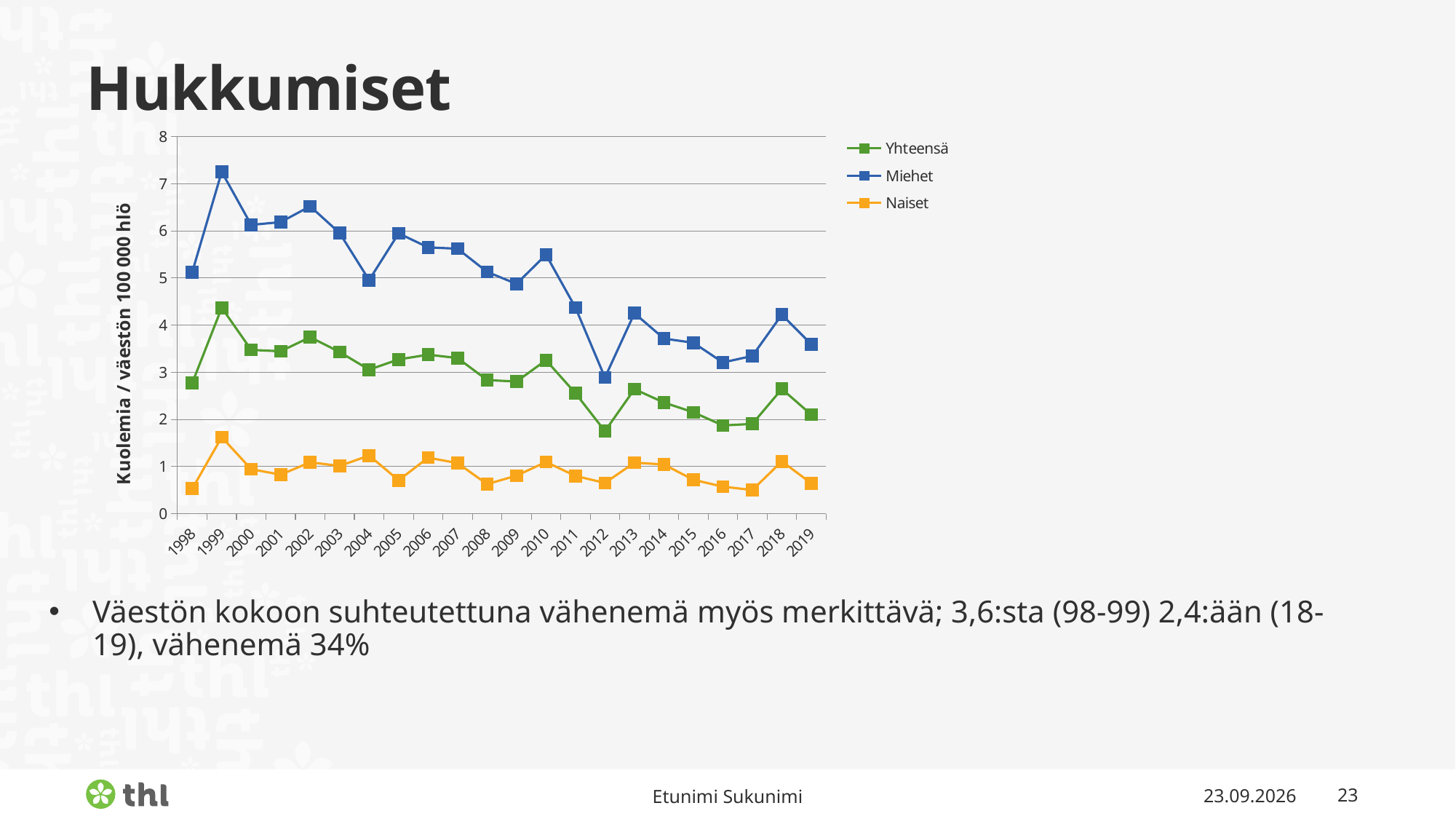
In which year does the Miehet series reach its highest value? 1999 What is the title of the vertical axis? Kuolemia / väestön 100 000 hlö How many years are plotted along the x axis? 22 In which year does the Naiset series reach its highest value? 1999 Is the value for Yhteensä in 2012 greater or less than 2? less Which series has the larger value in 2010, Miehet or Naiset? Miehet In which year does the Yhteensä series reach its highest value? 1999 What kind of chart is shown on the slide? line chart How many series does the legend list? 3 In which year does the Miehet series reach its lowest value? 2012 Is the value for Miehet in 1999 greater or less than 7? greater